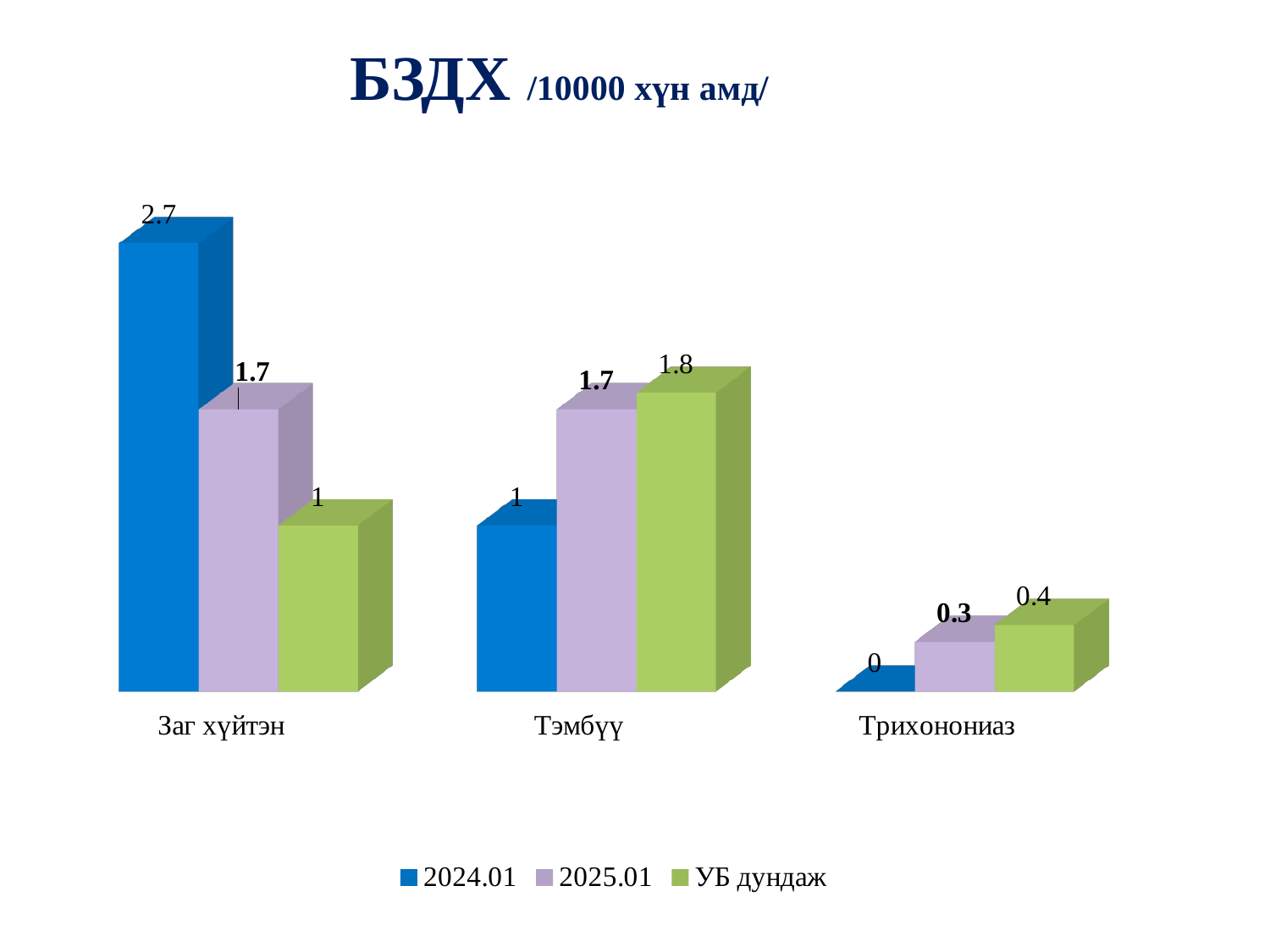
How many series does the legend list? 3 Which is larger for Тэмбүү: the 2024.01 value or the УБ дундаж value? УБ дундаж How many categories are shown on the x axis? 3 Which category has the highest 2024.01 value? Заг хүйтэн What is the УБ дундаж value for Трихонониаз? 0.4 What kind of chart is shown on the slide? Bar chart What is the value for Заг хүйтэн in the 2024.01 series? 2.7 What is the difference between the 2024.01 and 2025.01 values for Заг хүйтэн? 1 What is the value for Тэмбүү in the 2025.01 series? 1.7 Which category has the lowest УБ дундаж value? Трихонониаз What is the title of the chart? БЗДХ /10000 хүн амд/ What is the value for Трихонониаз in the 2024.01 series? 0